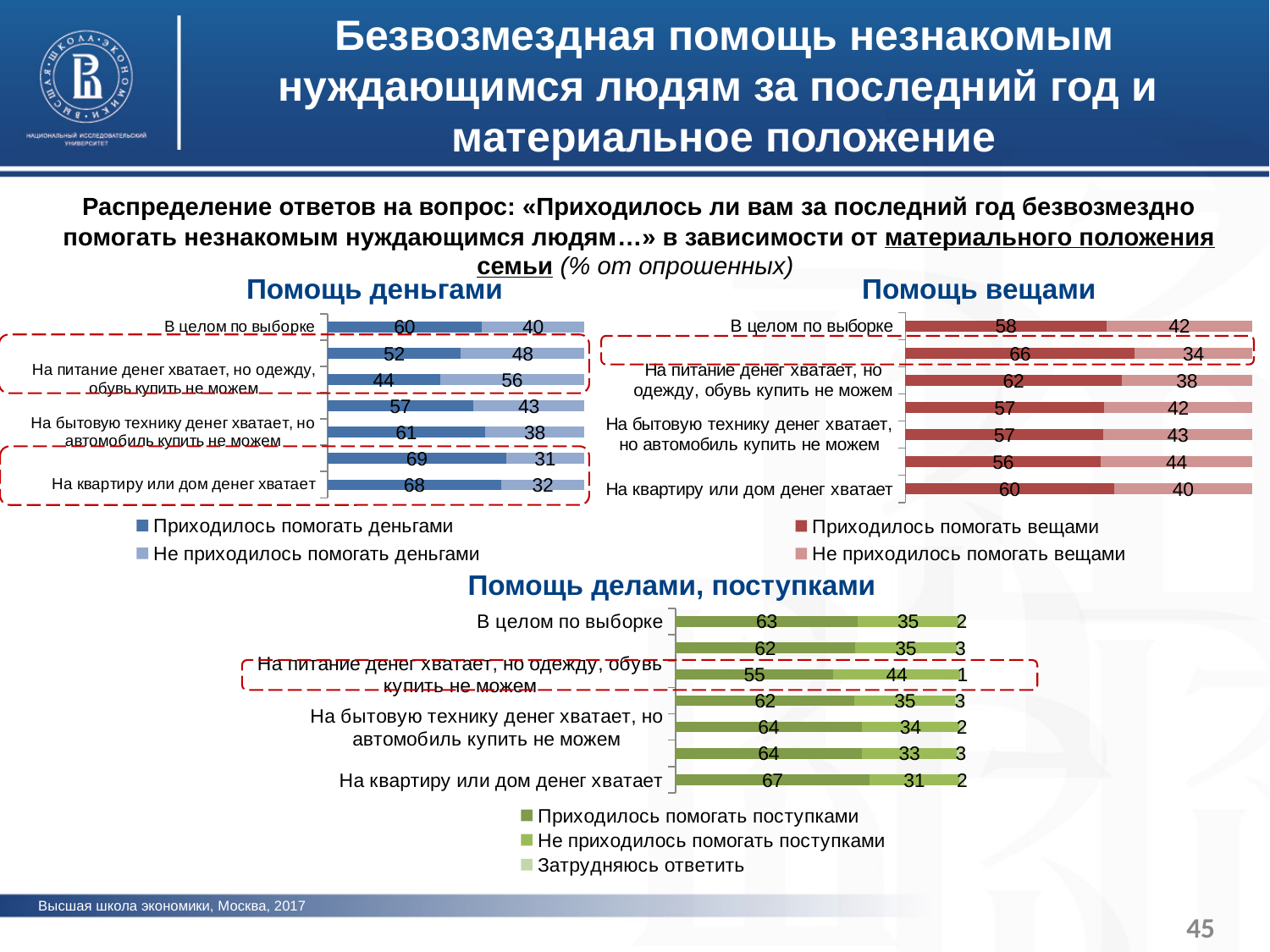
In the chart 'Помощь делами, поступками', what is the value of 'Не приходилось помогать поступками' for 'В целом по выборке'? 35 How many series does the legend of the chart 'Помощь делами, поступками' list? 3 What kind of chart is 'Помощь вещами'? Stacked bar chart In the chart 'Помощь вещами', what is the value of 'Приходилось помогать вещами' for 'В целом по выборке'? 58 In the chart 'Помощь делами, поступками', what is the total of the stacked bar for 'На квартиру или дом денег хватает'? 100 In the chart 'Помощь деньгами', what is the value of 'Не приходилось помогать деньгами' for 'На квартиру или дом денег хватает'? 32 In the chart 'Помощь деньгами', what is the value of 'Приходилось помогать деньгами' for 'В целом по выборке'? 60 How many series does the legend of the chart 'Помощь деньгами' list? 2 In the chart 'Помощь вещами', what is the value of 'Приходилось помогать вещами' for 'На квартиру или дом денег хватает'? 60 In the chart 'Помощь деньгами', what is the difference between 'Приходилось помогать деньгами' and 'Не приходилось помогать деньгами' for 'В целом по выборке'? 20 In the chart 'Помощь вещами', which is larger for 'В целом по выборке': 'Приходилось помогать вещами' or 'Не приходилось помогать вещами'? Приходилось помогать вещами In the chart 'Помощь делами, поступками', what is the value of 'Приходилось помогать поступками' for 'На квартиру или дом денег хватает'? 67